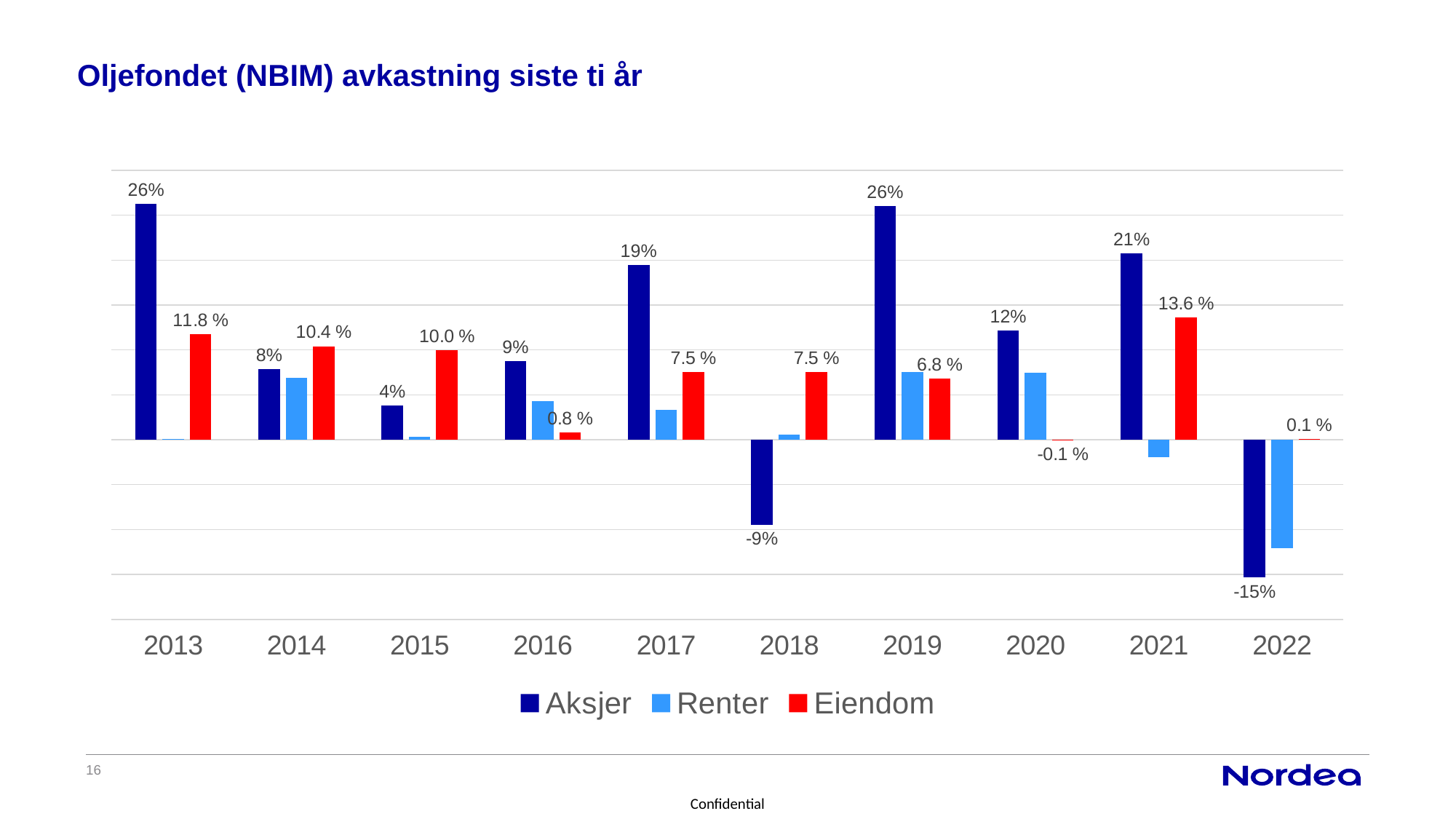
What is the value for Aksjer in 2022? -15% What is the value for Eiendom in 2021? 13.6 % In 2020, which is larger: the Aksjer value or the Eiendom value? Aksjer How many years are shown on the x axis? 10 What is the value for Eiendom in 2016? 0.8 % What kind of chart is shown on the slide? bar chart Do the Eiendom values rise or fall from 2013 to 2016? fall In which year is the Aksjer value lowest? 2022 What is the difference between the Eiendom values for 2013 and 2014? 1.4 % In which year is the Eiendom value highest? 2021 What is the value for Aksjer in 2017? 19% How many series does the legend list? 3